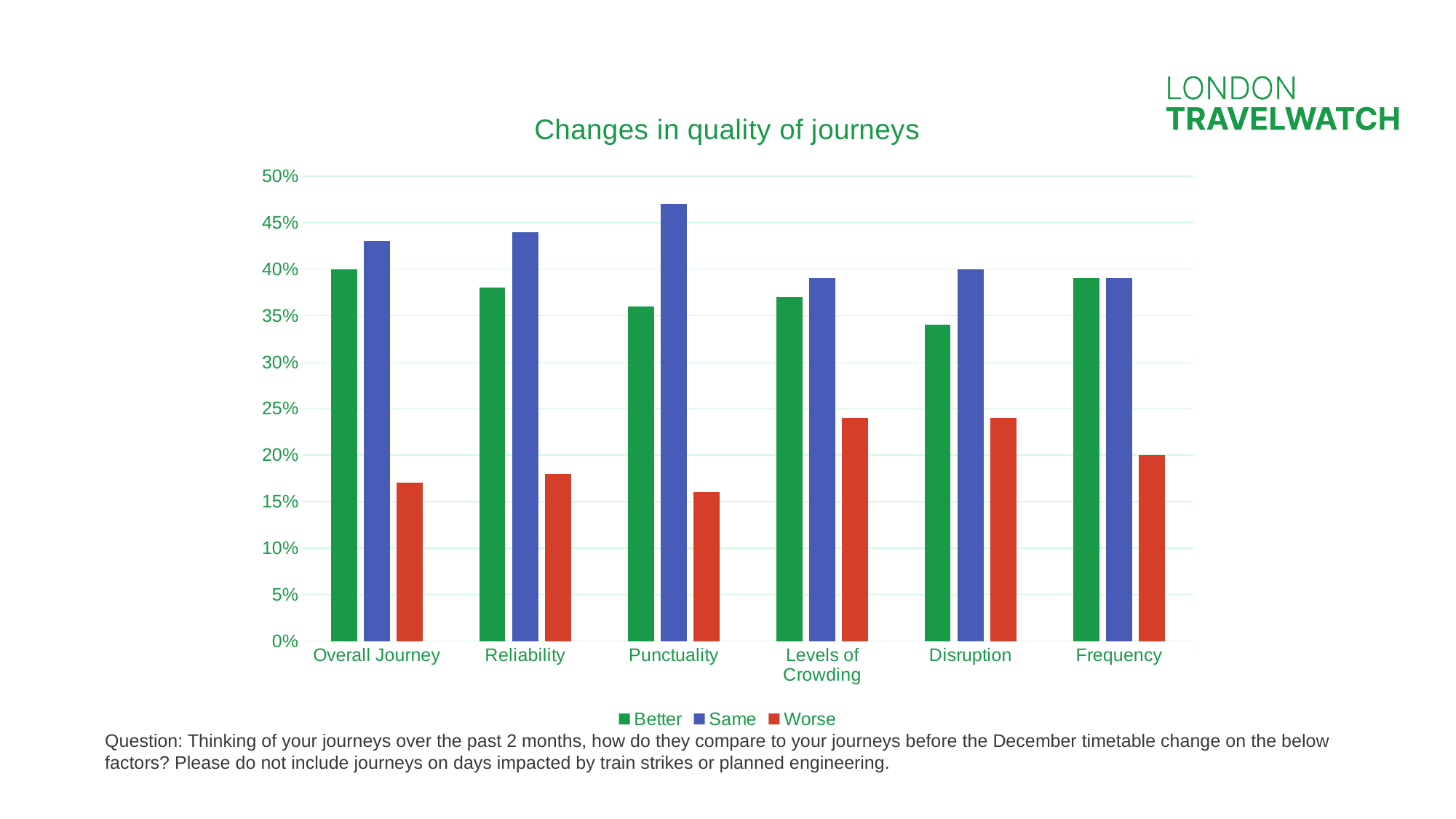
Is the Same value for Punctuality greater or less than 45%? greater What is the title of the chart? Changes in quality of journeys Which category has the highest value for the Same series? Punctuality Which is larger: the Worse value for Levels of Crowding or the Worse value for Punctuality? Levels of Crowding Is the Worse value for Levels of Crowding greater or less than 20%? greater How many series does the legend list? 3 Which category has the lowest value for the Better series? Disruption Which series is shown in red in the chart? Worse For Overall Journey, which is larger: the Better value or the Same value? Same Is the Worse value for Punctuality greater or less than 20%? less How many categories are shown on the x axis of the chart? 6 What kind of chart is shown on the slide? Bar chart